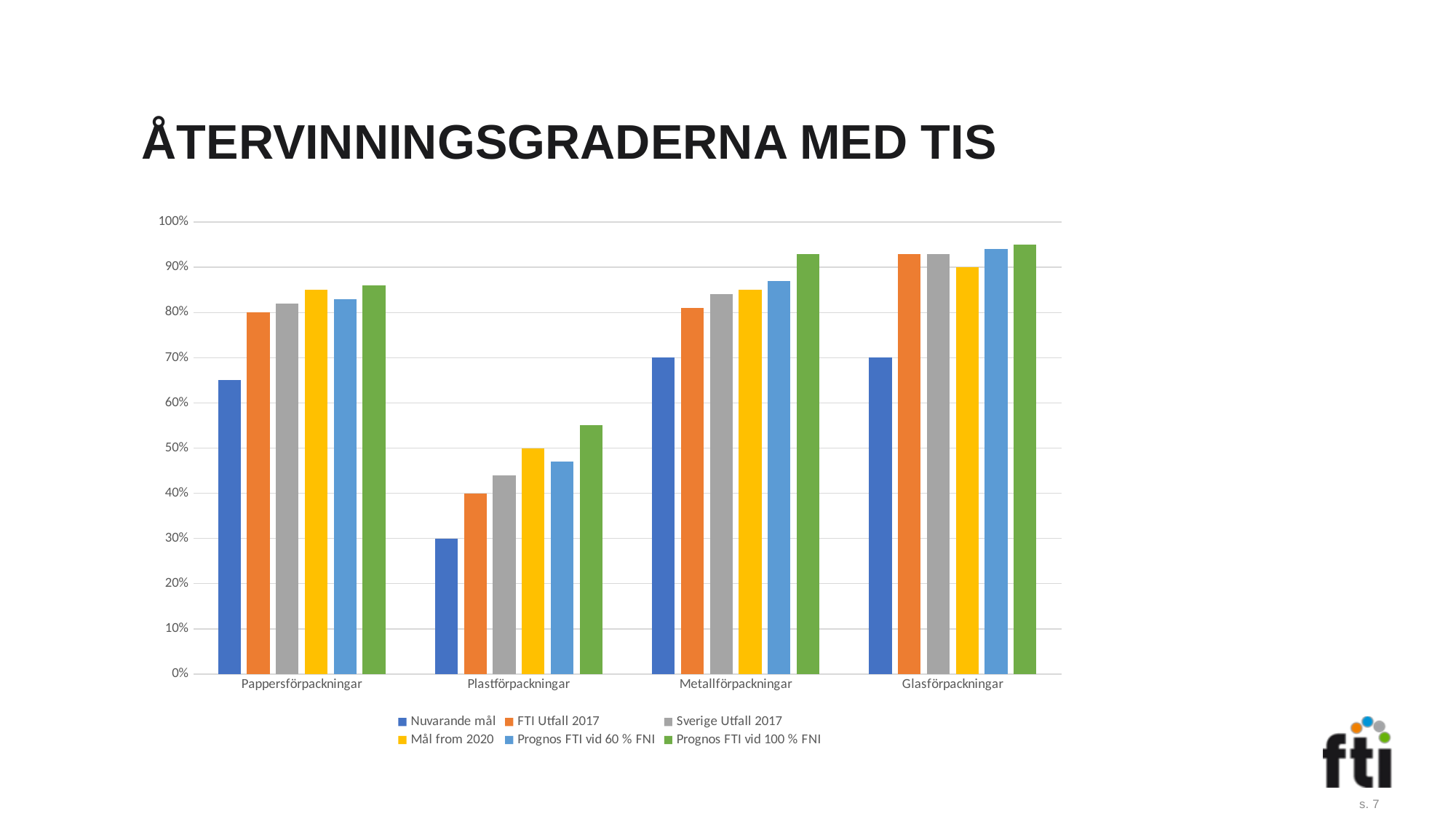
What kind of chart is shown on the slide? Bar chart What is the value of Nuvarande mål for Plastförpackningar? 30% How many series does the chart's legend list? 6 Which category has the lowest values across all series? Plastförpackningar What is the value of Mål from 2020 for Glasförpackningar? 90% Is the value of Nuvarande mål for Pappersförpackningar greater or less than 60%? greater What is the value of Nuvarande mål for Metallförpackningar? 70% How many categories are shown on the x axis of the chart? 4 Is the value of Prognos FTI vid 100 % FNI for Plastförpackningar greater or less than 50%? greater Which is larger: Nuvarande mål for Plastförpackningar or Nuvarande mål for Metallförpackningar? Metallförpackningar Which series has the highest value for Plastförpackningar? Prognos FTI vid 100 % FNI What is the title of the chart on the slide? ÅTERVINNINGSGRADERNA MED TIS